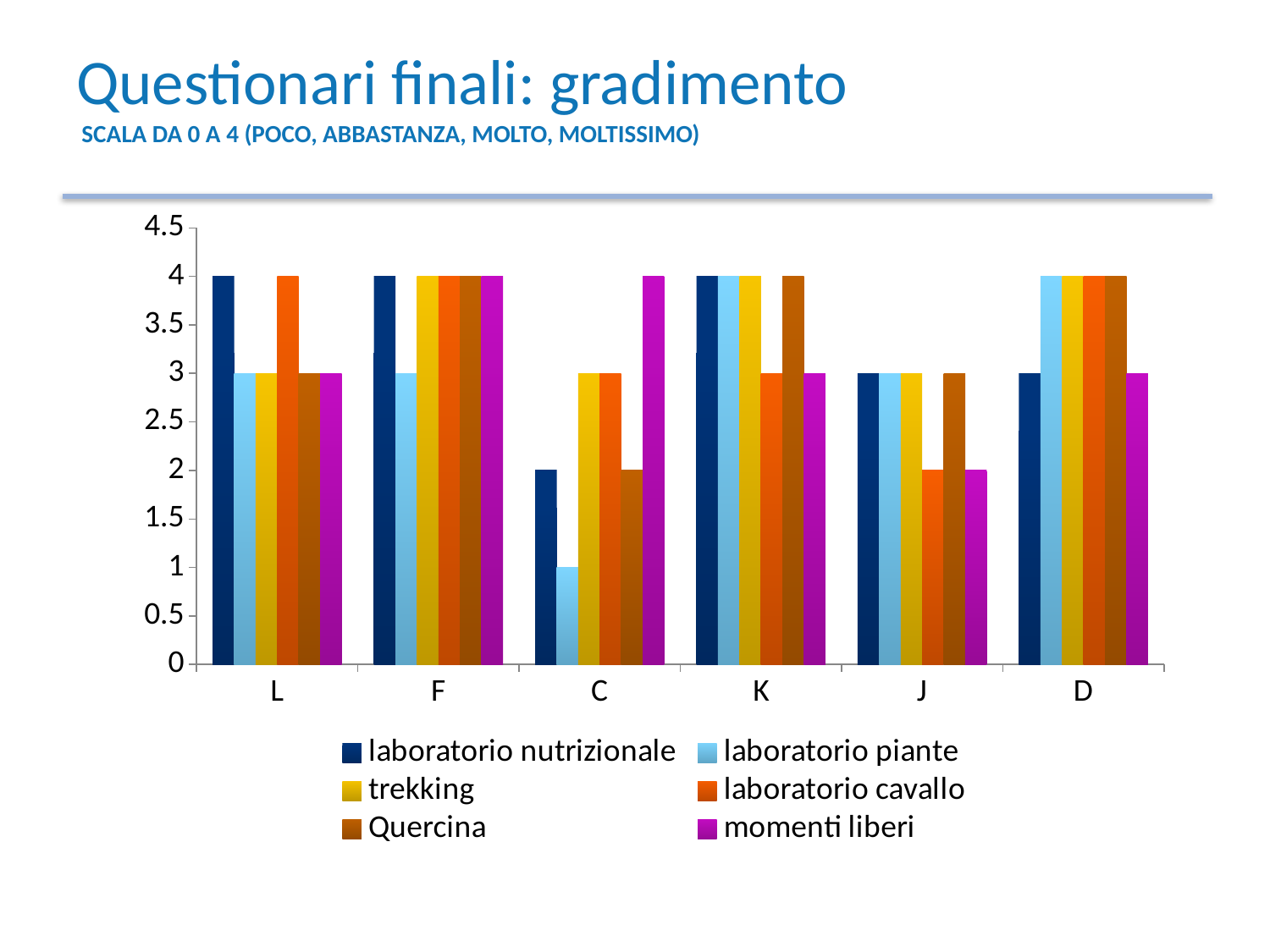
Which is larger for category K: laboratorio cavallo or Quercina? Quercina What is the title of the slide? Questionari finali: gradimento What value does laboratorio nutrizionale have for category D? 3 For which category is the laboratorio nutrizionale value lowest? C What value does laboratorio cavallo have for category J? 2 What kind of chart is shown on the slide? bar chart What value does momenti liberi have for category C? 4 How many series does the legend list? 6 What is the difference between the momenti liberi value and the laboratorio piante value for category C? 3 For which category is the laboratorio piante value lowest? C How many categories are shown on the x axis? 6 What value does laboratorio piante have for category C? 1